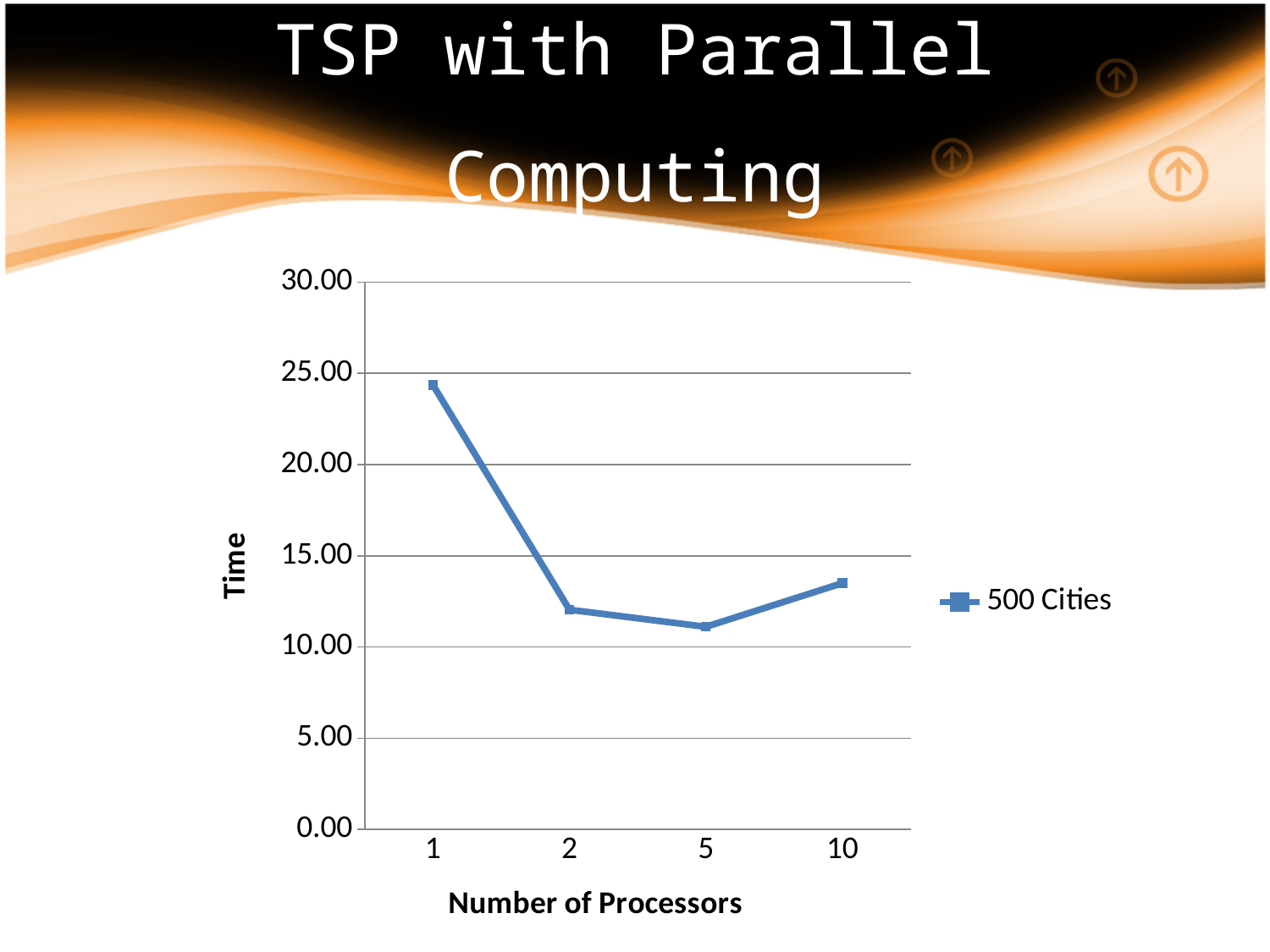
What kind of chart is shown on the slide? line chart What is the name of the series shown in the legend? 500 Cities What is the title of the x axis? Number of Processors Is the time for 2 processors greater or less than 15.00? less How many points are plotted along the x axis? 4 Is the time for 1 processor greater or less than 20.00? greater How many series does the legend list? 1 Which has the larger time, 1 processor or 10 processors? 1 processor Is the time for 10 processors greater or less than 15.00? less How does the time change as the number of processors increases from 1 to 10? falls, then rises slightly at 10 Which number of processors has the highest time? 1